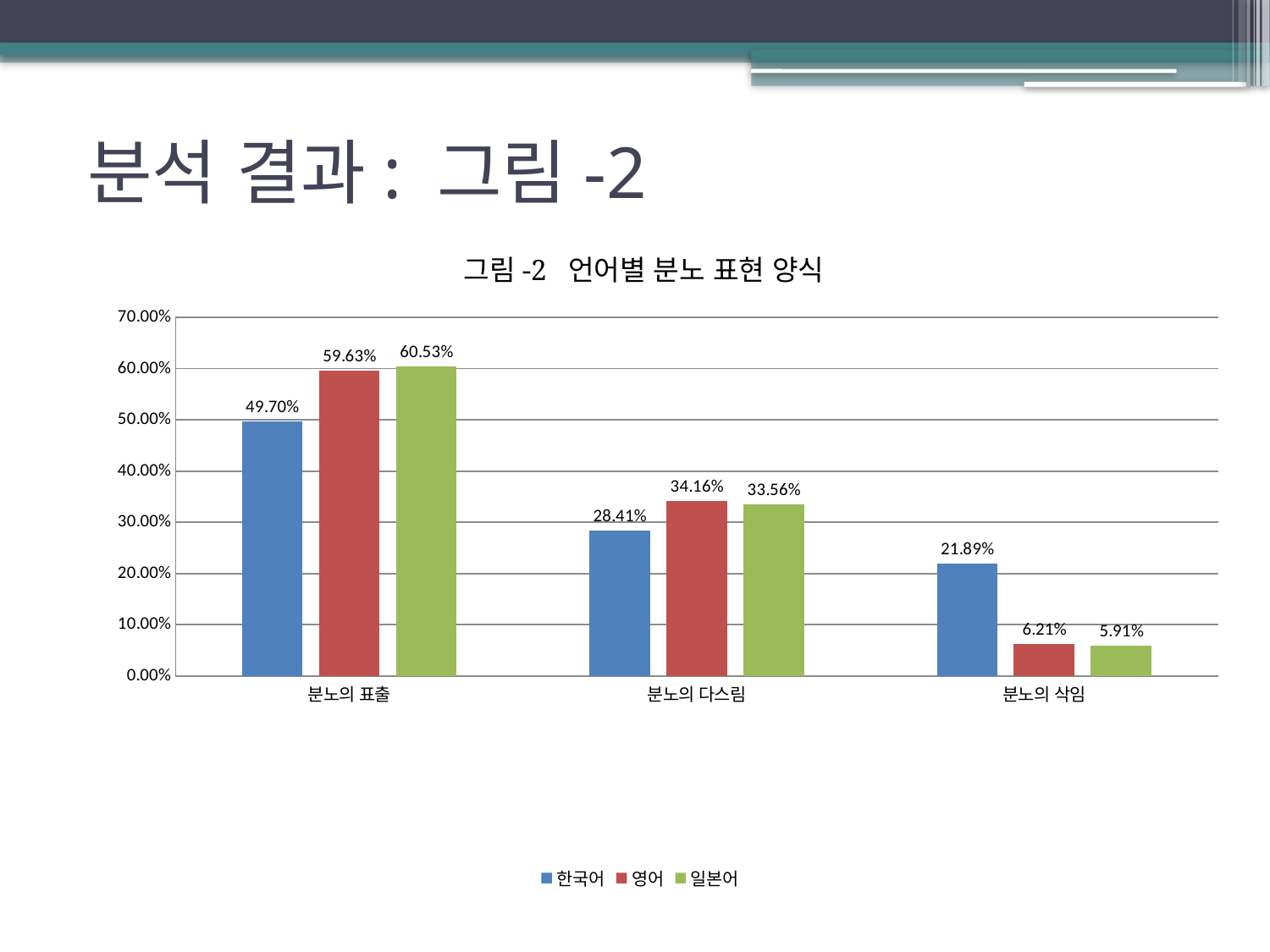
What is the difference between the 영어 and 한국어 values in the 분노의 표출 category? 9.93% Which series has the lowest value in the 분노의 삭임 category? 일본어 Is the value for 한국어 in the 분노의 삭임 category greater or less than 20.00%? greater What is the title of the chart? 그림 -2 언어별 분노 표현 양식 Which series has the highest value in the 분노의 표출 category? 일본어 What is the value for 영어 in the 분노의 삭임 category? 6.21% What is the value for 일본어 in the 분노의 다스림 category? 33.56% What is the value for 한국어 in the 분노의 표출 category? 49.70% How many series does the legend list? 3 What kind of chart is shown on the slide? bar chart How many categories are shown on the x axis? 3 Which is larger in the 분노의 다스림 category: the value for 한국어 or the value for 영어? 영어